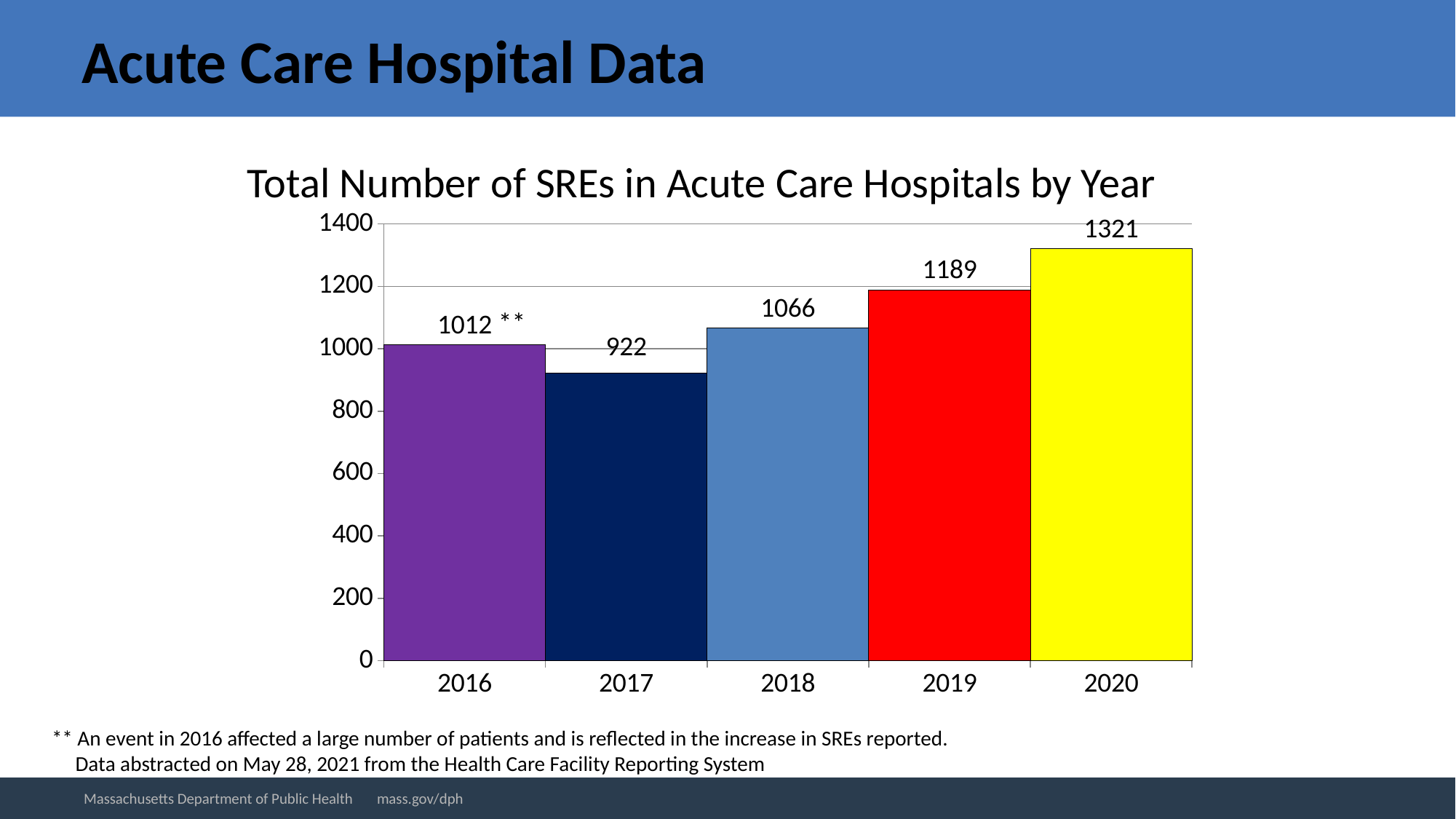
What is the difference between the number of SREs in 2016 and in 2017? 90 Which year has the highest total number of SREs? 2020 What is the difference between the number of SREs in 2020 and in 2019? 132 Which year had more SREs, 2018 or 2019? 2019 What is the total number of SREs in acute care hospitals in 2018? 1066 What is the title of the chart? Total Number of SREs in Acute Care Hospitals by Year What kind of chart is used to show the total number of SREs by year? Bar chart Is the value for 2017 greater or less than 1000? less What is the total number of SREs in acute care hospitals in 2020? 1321 What is the total number of SREs in acute care hospitals in 2017? 922 Which year has the lowest total number of SREs? 2017 How many years are shown on the chart? 5